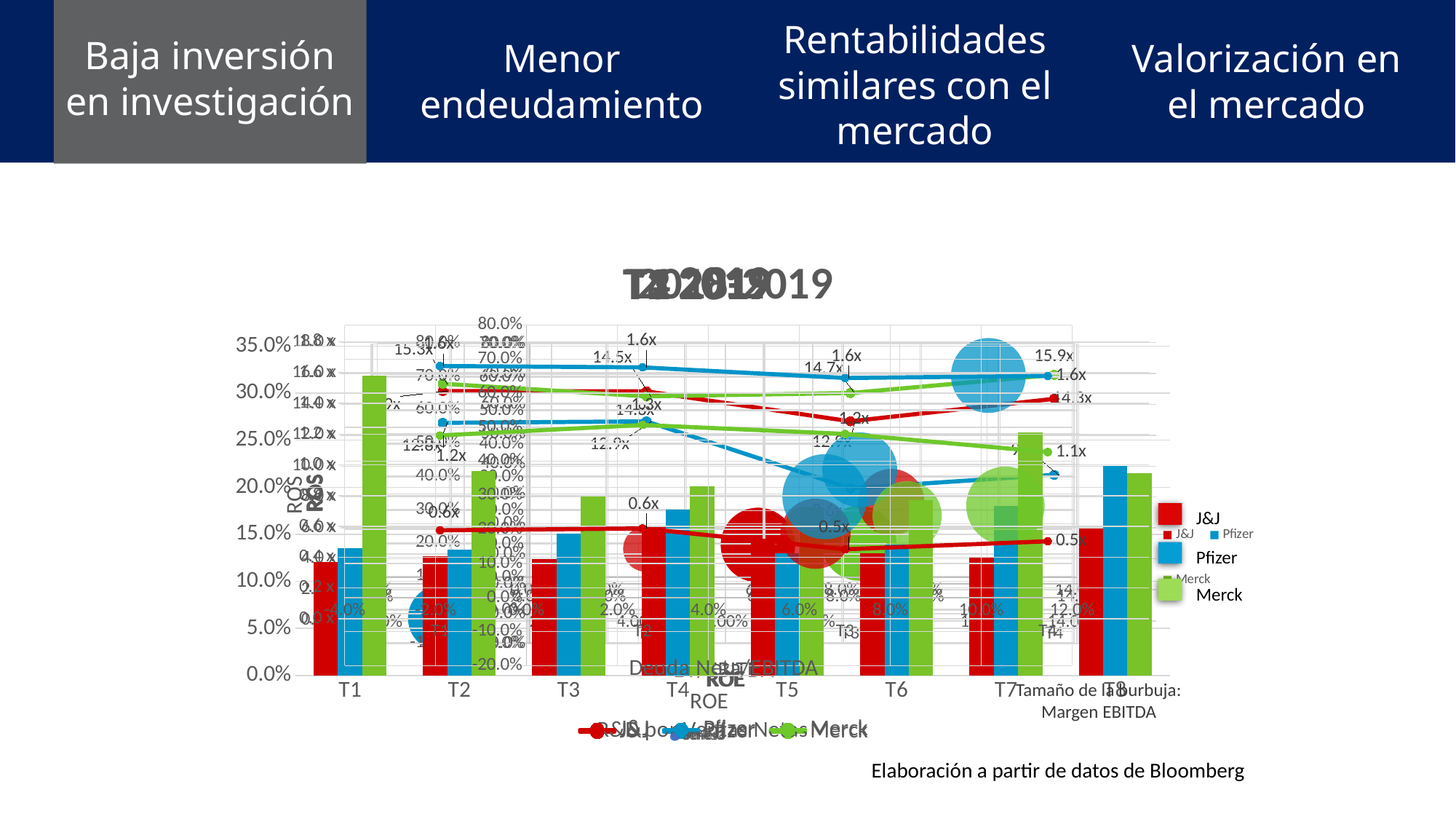
According to the bubble chart's note, what does the bubble size represent? Margen EBITDA In the bar chart with categories T1 to T8, is the Merck value at T1 greater or less than 25.0%? greater In the bar chart with categories T1 to T8, is the J&J value at T1 greater or less than 15.0%? less In the bar chart with categories T1 to T8, is the Merck value at T7 greater or less than 20.0%? greater In the bar chart with categories T1 to T8, how many series does the legend list? 3 In the bar chart with categories T1 to T8, how many categories are shown on the x axis? 8 In the bar chart with categories T1 to T8, which is larger at T1: the Merck bar or the Pfizer bar? Merck In the bar chart with categories T1 to T8, what colour are the J&J bars? red In the bar chart with categories T1 to T8, which company has the shortest bar at T1? J&J In the bar chart with categories T1 to T8, which company has the tallest bar at T1? Merck What kind of chart is the one with categories T1 to T8 along the x axis? bar chart